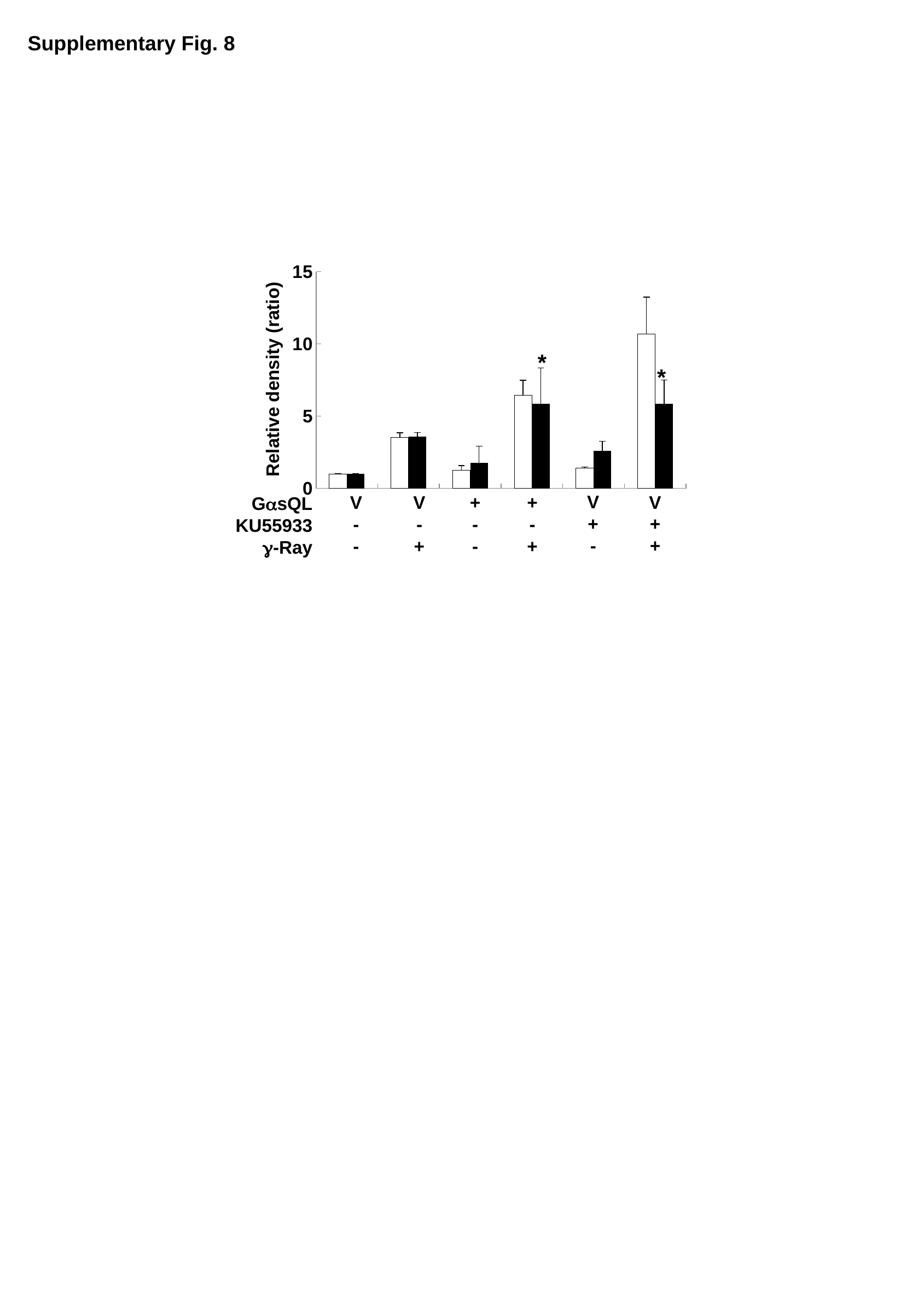
What is the highest value shown on the y axis? 15 Which is larger: the white bar in the sixth group (GαsQL V, KU55933 +, γ-Ray +) or the white bar in the fourth group (GαsQL +, KU55933 -, γ-Ray +)? the white bar in the sixth group Is the black bar in the second group (GαsQL V, KU55933 -, γ-Ray +) greater or less than 5? less What kind of chart is shown on the slide? bar chart How many bars are there in each group along the x axis? 2 How many groups of bars are plotted along the x axis? 6 Which is larger: the white bar in the fourth group (GαsQL +, KU55933 -, γ-Ray +) or the white bar in the second group (GαsQL V, KU55933 -, γ-Ray +)? the white bar in the fourth group Which group has the tallest bar in the chart? the sixth group (GαsQL V, KU55933 +, γ-Ray +) Is the white bar in the fourth group (GαsQL +, KU55933 -, γ-Ray +) greater or less than 10? less What is the label of the y axis? Relative density (ratio) Is the white bar in the sixth group (GαsQL V, KU55933 +, γ-Ray +) greater or less than 5? greater Which group has the lowest bars in the chart? the first group (GαsQL V, KU55933 -, γ-Ray -)